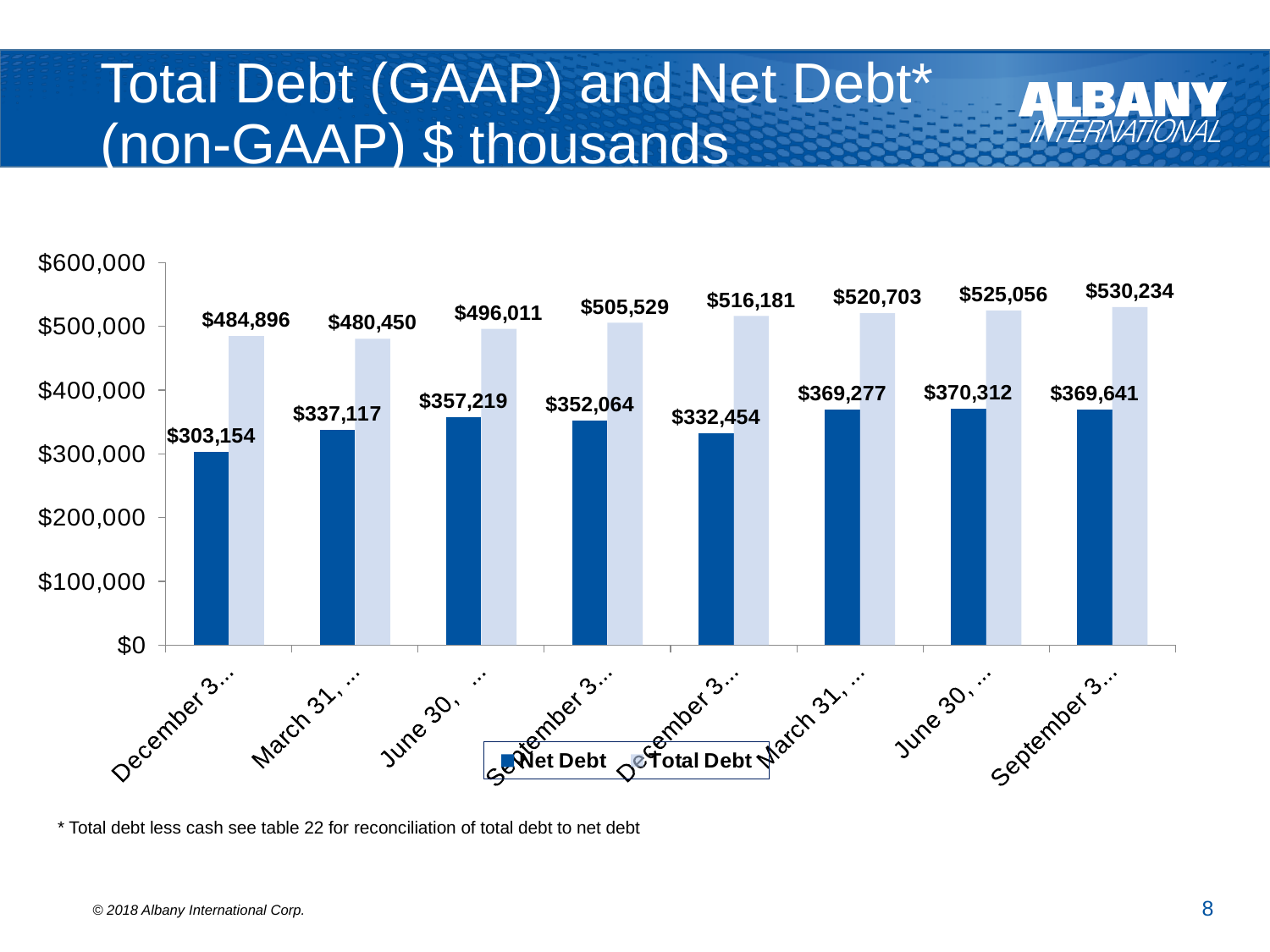
Which period has the lowest Net Debt value? The first period (December 3...), $303,154 Which is larger in the fifth period: Net Debt or Total Debt? Total Debt What is the Total Debt value for the last period on the right? $530,234 What kind of chart is shown on the slide? Bar chart What is the difference between Total Debt and Net Debt in the first period? $181,742 Is the Net Debt value for the second period greater or less than $300,000? greater What is the Net Debt value for the first period on the left? $303,154 Which period has the highest Total Debt value? The last period (September 3...), $530,234 Does Total Debt generally rise or fall from the third period to the last period? Rise How many series does the legend list? 2 How many periods (categories) are plotted along the x axis? 8 What is the Total Debt value for the fourth period from the left? $505,529